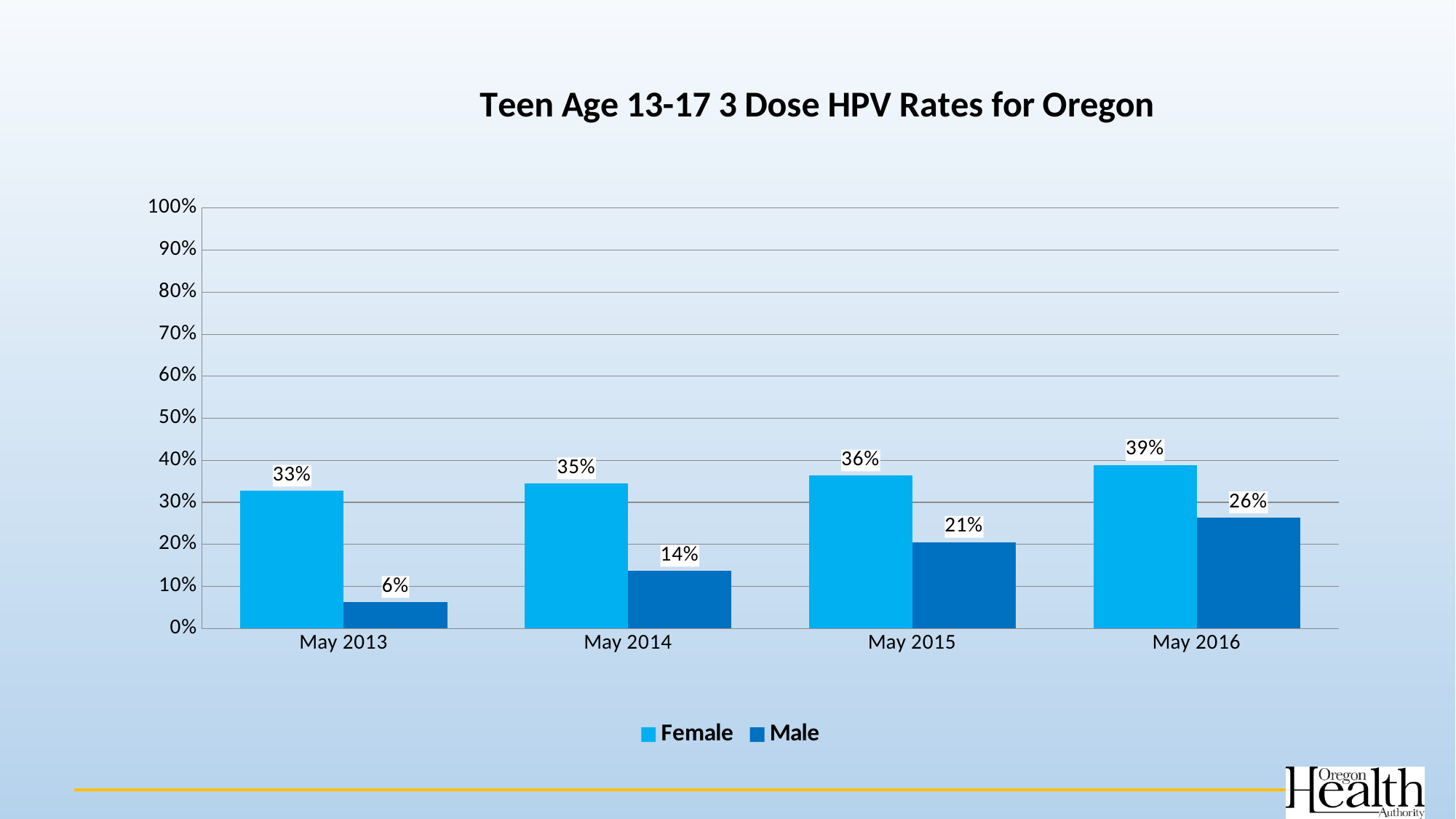
Do the Male values rise or fall from May 2013 to May 2016? rise How many series does the legend list? 2 How many categories are shown on the x axis? 4 What is the difference between the Male values for May 2016 and May 2013? 20% What kind of chart is this? bar chart What is the Male value for May 2016? 26% Which category has the lowest Male value? May 2013 Which is larger, the Male value for May 2015 or the Male value for May 2014? May 2015 What is the difference between the Female and Male values for May 2015? 15% What is the Male value for May 2013? 6% Which category has the highest Female value? May 2016 What is the Female value for May 2014? 35%